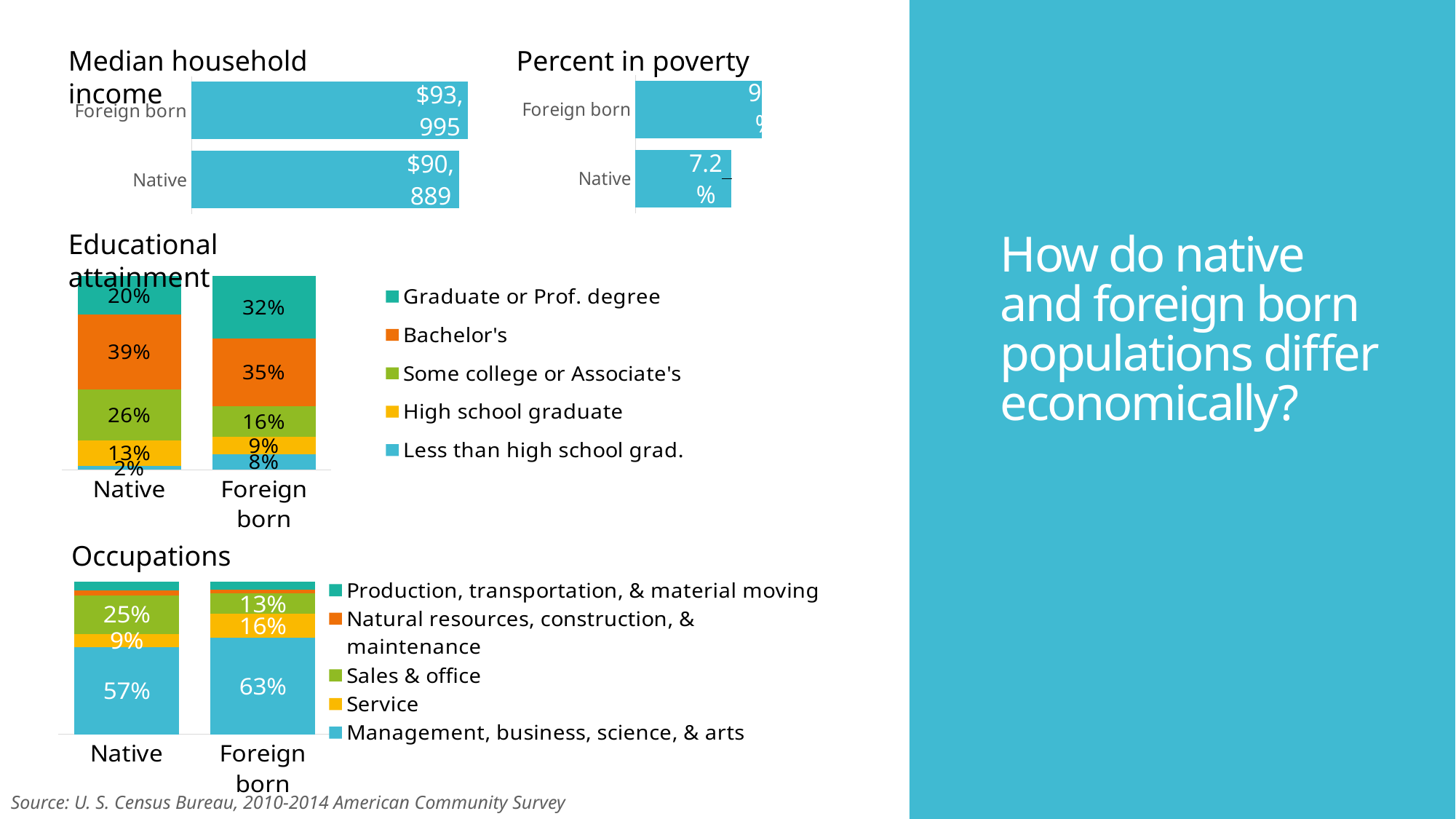
In the Occupations chart, what percentage of the Foreign born population works in Service occupations? 16% In the Percent in poverty chart, what is the percent in poverty for the Native population? 7.2% In the Percent in poverty chart, which group has the higher percent in poverty, Foreign born or Native? Foreign born In the Median household income chart, what is the median household income for the Native population? $90,889 In the Educational attainment chart, how many categories does the legend list? 5 In the Occupations chart, what percentage of the Native population works in Management, business, science, & arts? 57% In the Educational attainment chart, what percentage of the Foreign born population has a Graduate or Prof. degree? 32% In the Median household income chart, how much higher is the Foreign born median household income than the Native one? $3,106 In the Educational attainment chart, what percentage of the Native population has a Bachelor's degree? 39% What type of chart is the Occupations chart? Stacked bar chart In the Educational attainment chart, what is the difference in percentage points between Native and Foreign born for Some college or Associate's? 10 percentage points In the Median household income chart, what is the median household income for the Foreign born population? $93,995